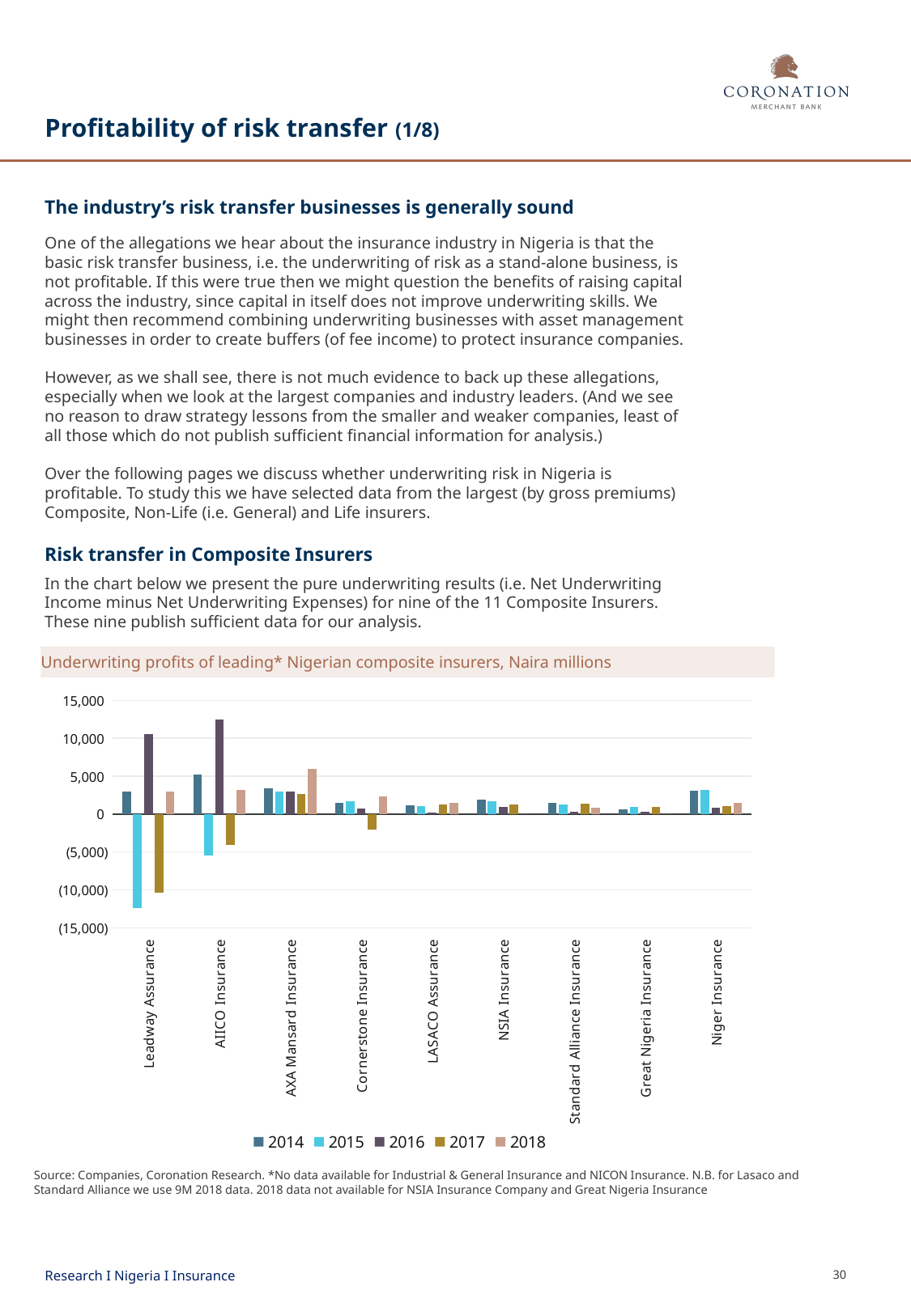
Is the 2018 value for AXA Mansard Insurance greater or less than 5,000? greater Which insurer has the lowest 2015 value? Leadway Assurance Is the 2017 value for Cornerstone Insurance greater or less than 0? less How many series does the chart's legend list? 5 What is the title of the chart? Underwriting profits of leading* Nigerian composite insurers, Naira millions Is the 2016 value for AIICO Insurance greater or less than 10,000? greater Which is larger, the 2018 value for AXA Mansard Insurance or the 2018 value for Cornerstone Insurance? AXA Mansard Insurance How many insurers are shown on the x axis of the chart? 9 What kind of chart is shown on the slide? bar chart Which years are listed in the chart's legend? 2014, 2015, 2016, 2017, 2018 Which insurer has the highest 2016 value? AIICO Insurance